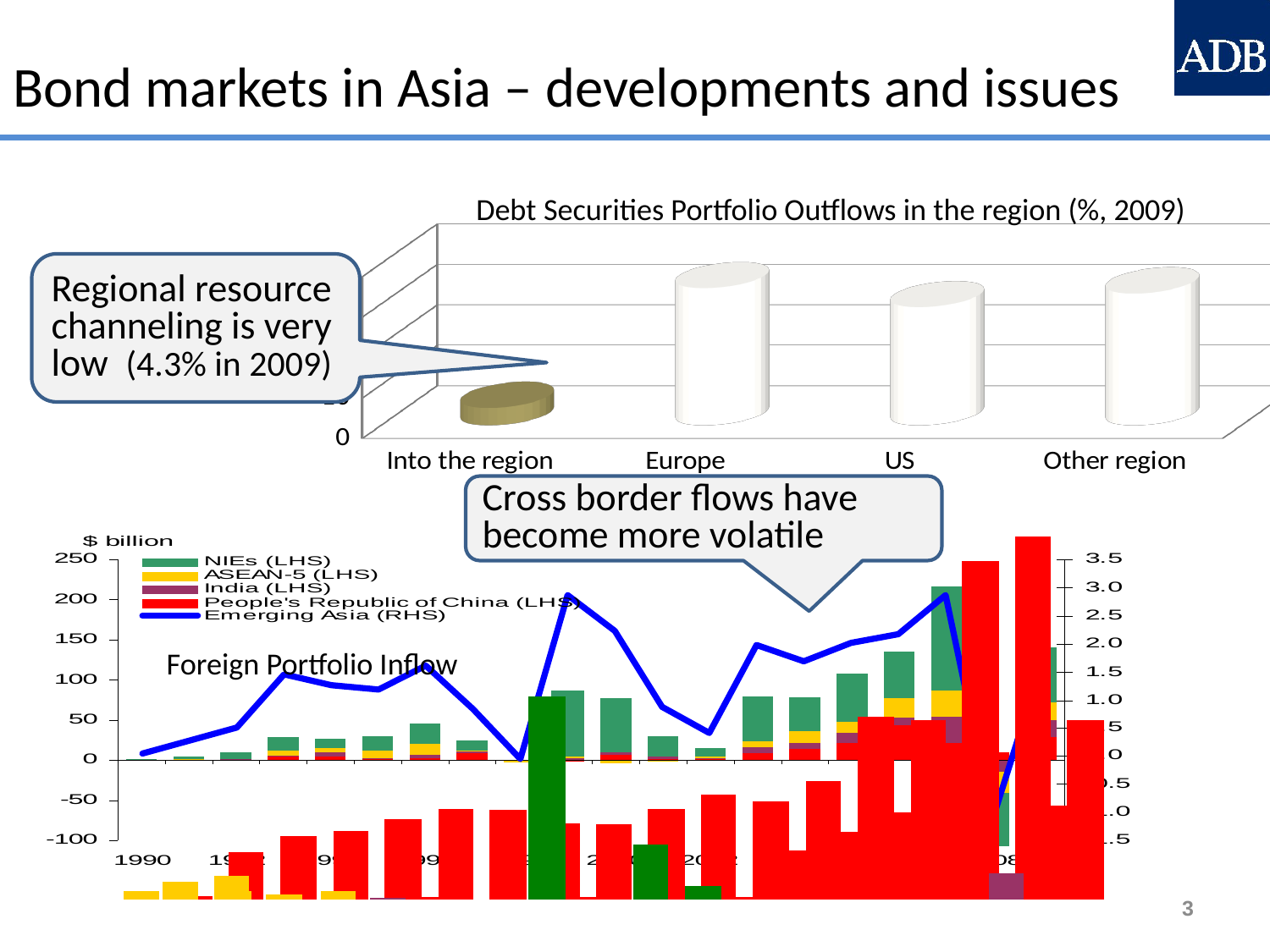
What is the highest value shown on the left-hand axis of the bottom chart, 'Foreign Portfolio Inflow'? 250 How many series does the legend of the bottom chart, 'Foreign Portfolio Inflow', list? 5 In the top chart, 'Debt Securities Portfolio Outflows in the region (%, 2009)', which is larger: the value for Into the region or the value for Europe? Europe What kind of chart is the top chart titled 'Debt Securities Portfolio Outflows in the region (%, 2009)'? Bar chart How many categories are shown on the x axis of the top chart, 'Debt Securities Portfolio Outflows in the region (%, 2009)'? 4 What is the highest value shown on the right-hand axis of the bottom chart, 'Foreign Portfolio Inflow'? 3.5 What is the title of the top chart on the slide? Debt Securities Portfolio Outflows in the region (%, 2009) In the top chart, 'Debt Securities Portfolio Outflows in the region (%, 2009)', which category has the lowest value? Into the region In the bottom chart, 'Foreign Portfolio Inflow', which series is plotted on the right-hand axis (RHS)? Emerging Asia (RHS) What kind of chart is the bottom chart, 'Foreign Portfolio Inflow'? Combination of stacked bar chart and line chart